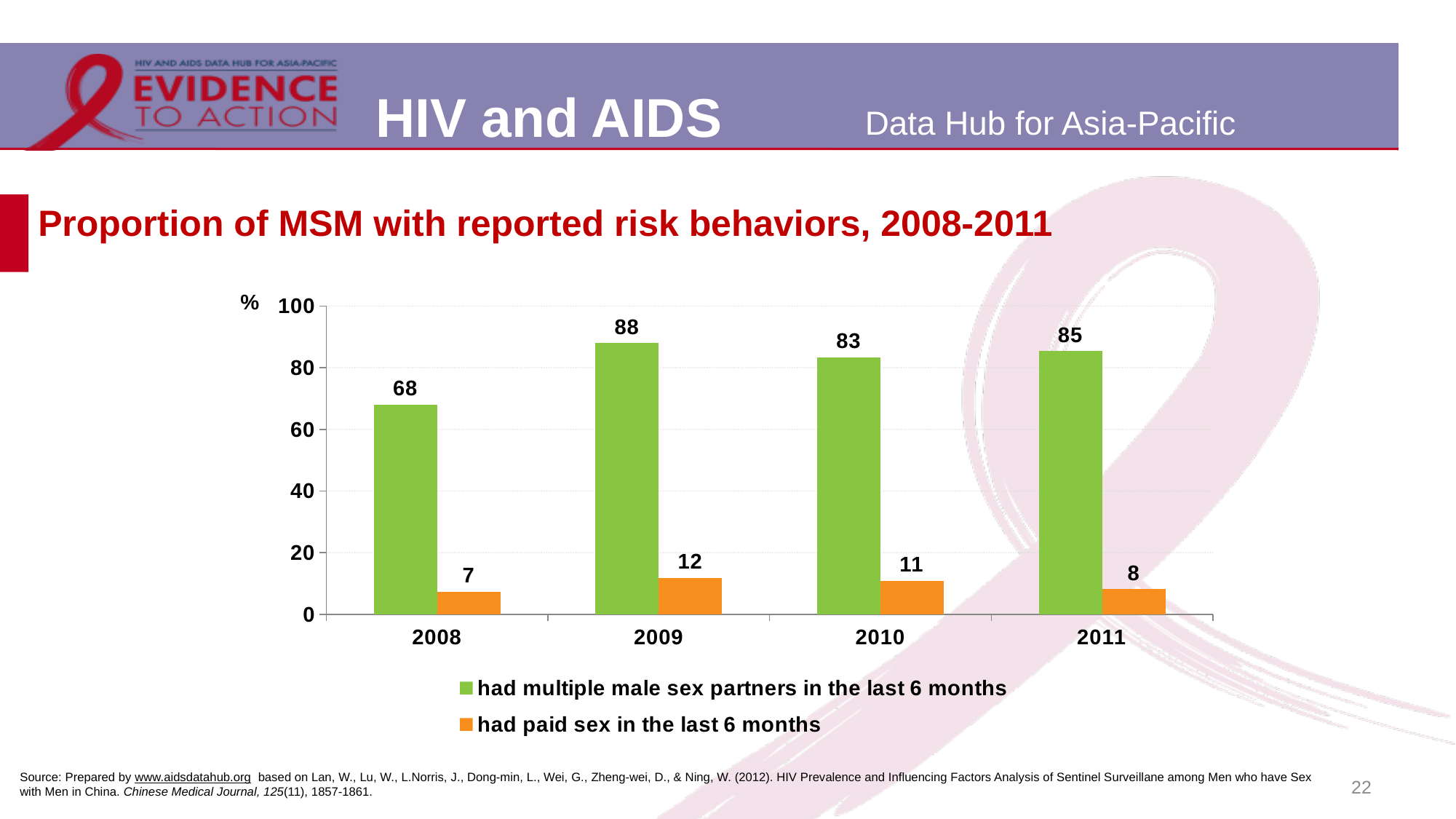
How many years are shown on the x axis of the chart? 4 How many series does the legend list? 2 Did the proportion of MSM who had multiple male sex partners rise or fall from 2008 to 2009? rise What is the difference between the proportion who had multiple male sex partners and the proportion who had paid sex in 2011? 77 Which colour represents MSM who had paid sex in the last 6 months? orange What percentage of MSM had paid sex in the last 6 months in 2010? 11 In which year was the proportion of MSM who had paid sex in the last 6 months the highest? 2009 What kind of chart is shown on the slide? bar chart Is the value for MSM who had multiple male sex partners in 2010 greater or less than 80? greater In which year was the proportion of MSM who had multiple male sex partners in the last 6 months the lowest? 2008 Which is larger: the proportion who had paid sex in 2008 or in 2011? 2011 What percentage of MSM had multiple male sex partners in the last 6 months in 2009? 88